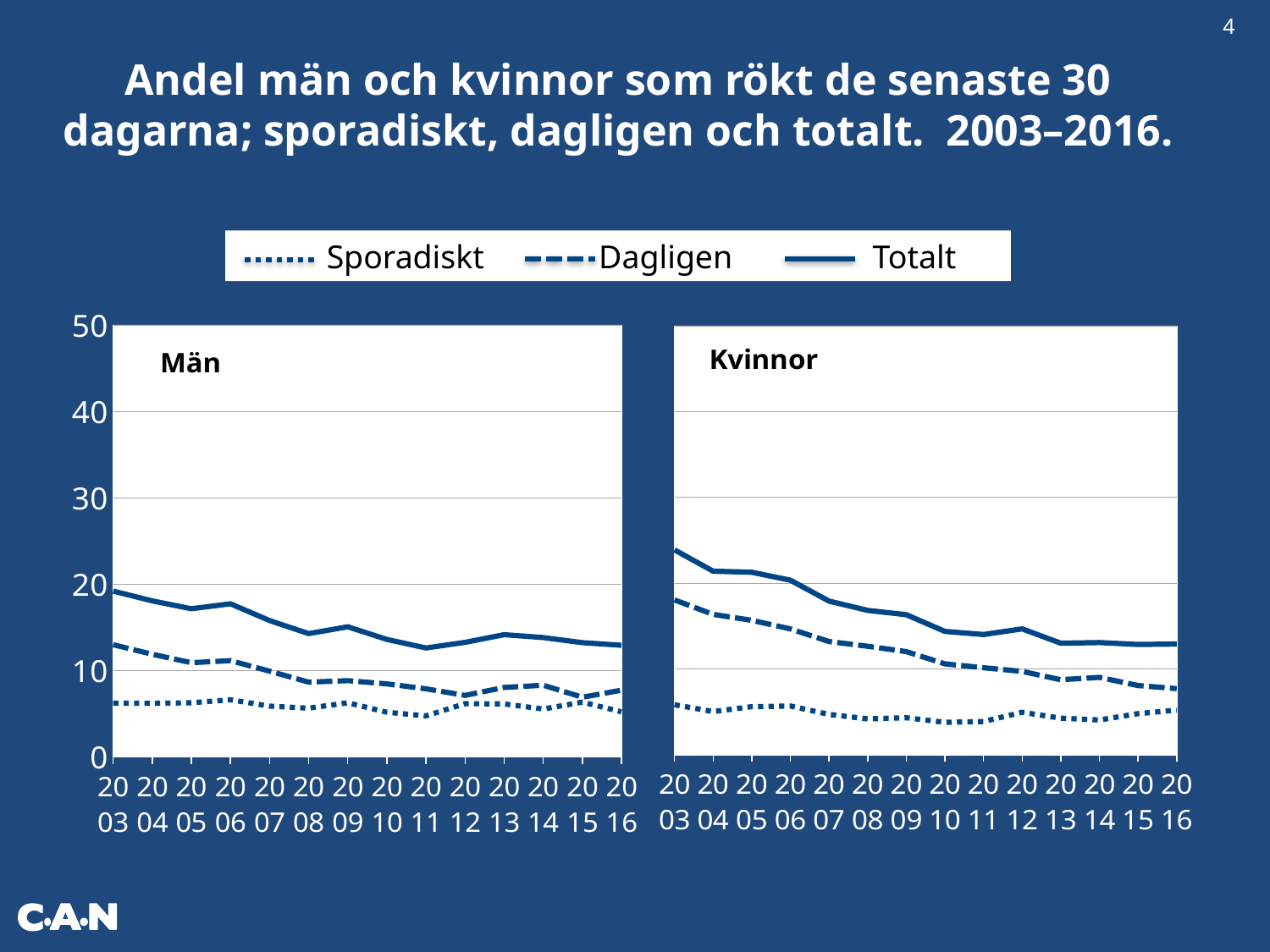
Which series is drawn with a solid line in the legend? Totalt In the "Kvinnor" chart, is the Sporadiskt value for 2016 greater or less than 10? less What is the title of the left chart? Män Which is larger for 2003: the Totalt value in the "Kvinnor" chart or the Totalt value in the "Män" chart? Kvinnor In the "Kvinnor" chart, which year has the highest Totalt value? 2003 In the "Kvinnor" chart, does the Dagligen line rise or fall from 2003 to 2016? fall What kind of chart is the "Män" chart? line chart In the "Män" chart, does the Totalt line rise or fall from 2003 to 2016? fall How many years are plotted along the x axis of the "Kvinnor" chart? 14 In the "Män" chart, is the Totalt value for 2016 greater or less than 20? less In the "Kvinnor" chart, is the Totalt value for 2003 greater or less than 20? greater How many series does the legend list? 3